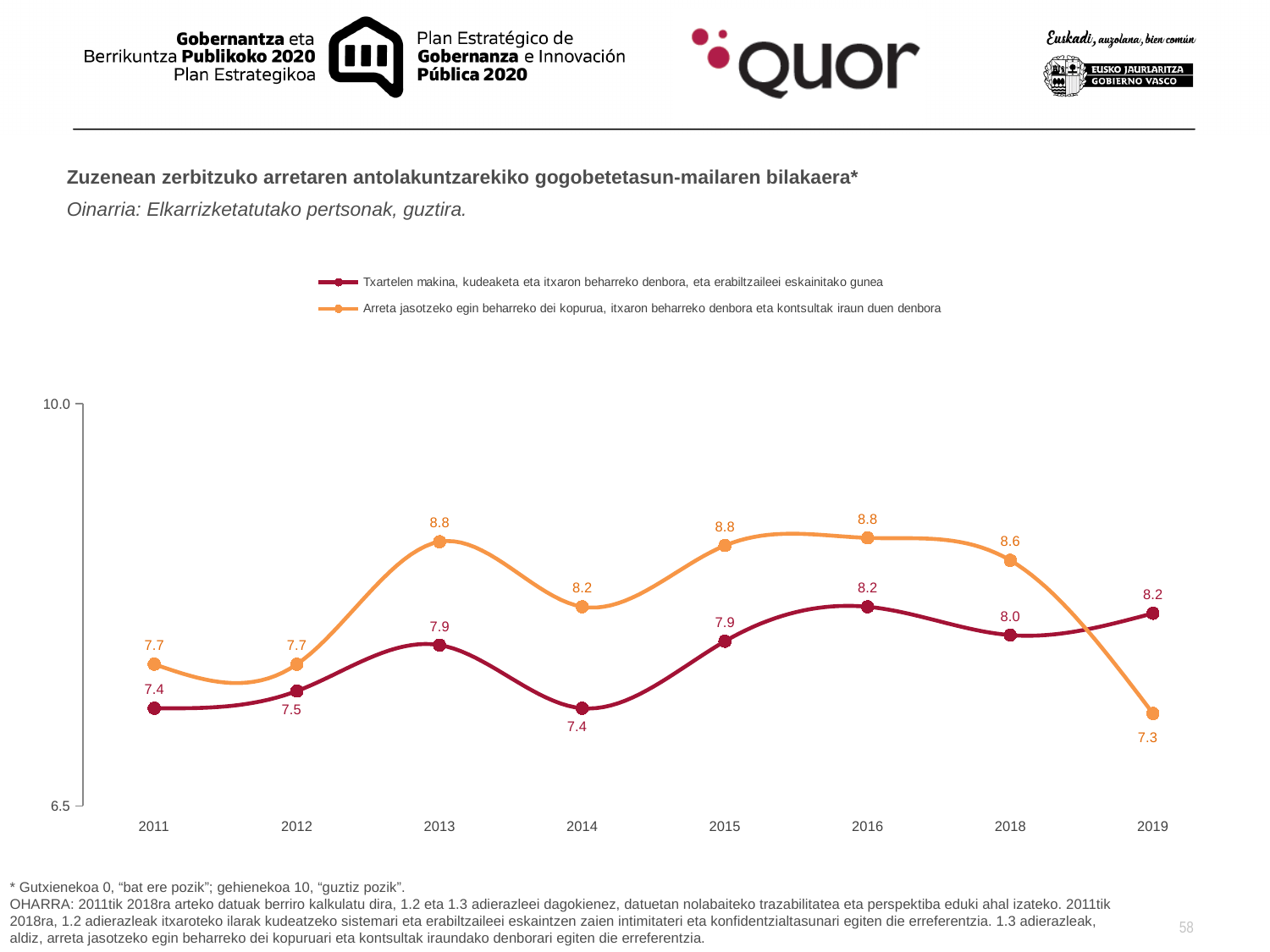
What kind of chart is shown on the slide? line chart In which year is the orange series at its lowest? 2019 How many years are shown on the x axis? 8 How many series does the legend list? 2 In which year does the red series reach its highest value for the first time? 2016 In 2019, which series has the higher value, the red or the orange one? the red series What is the difference between the orange and red series in 2013? 0.9 What is the difference between the red series values in 2011 and 2019? 0.8 Does the orange series rise or fall between 2018 and 2019? fall What is the value of the orange series in 2019? 7.3 What is the value of the red series (Txartelen makina, kudeaketa eta itxaron beharreko denbora...) in 2014? 7.4 What is the value of the orange series (Arreta jasotzeko egin beharreko dei kopurua...) in 2013? 8.8